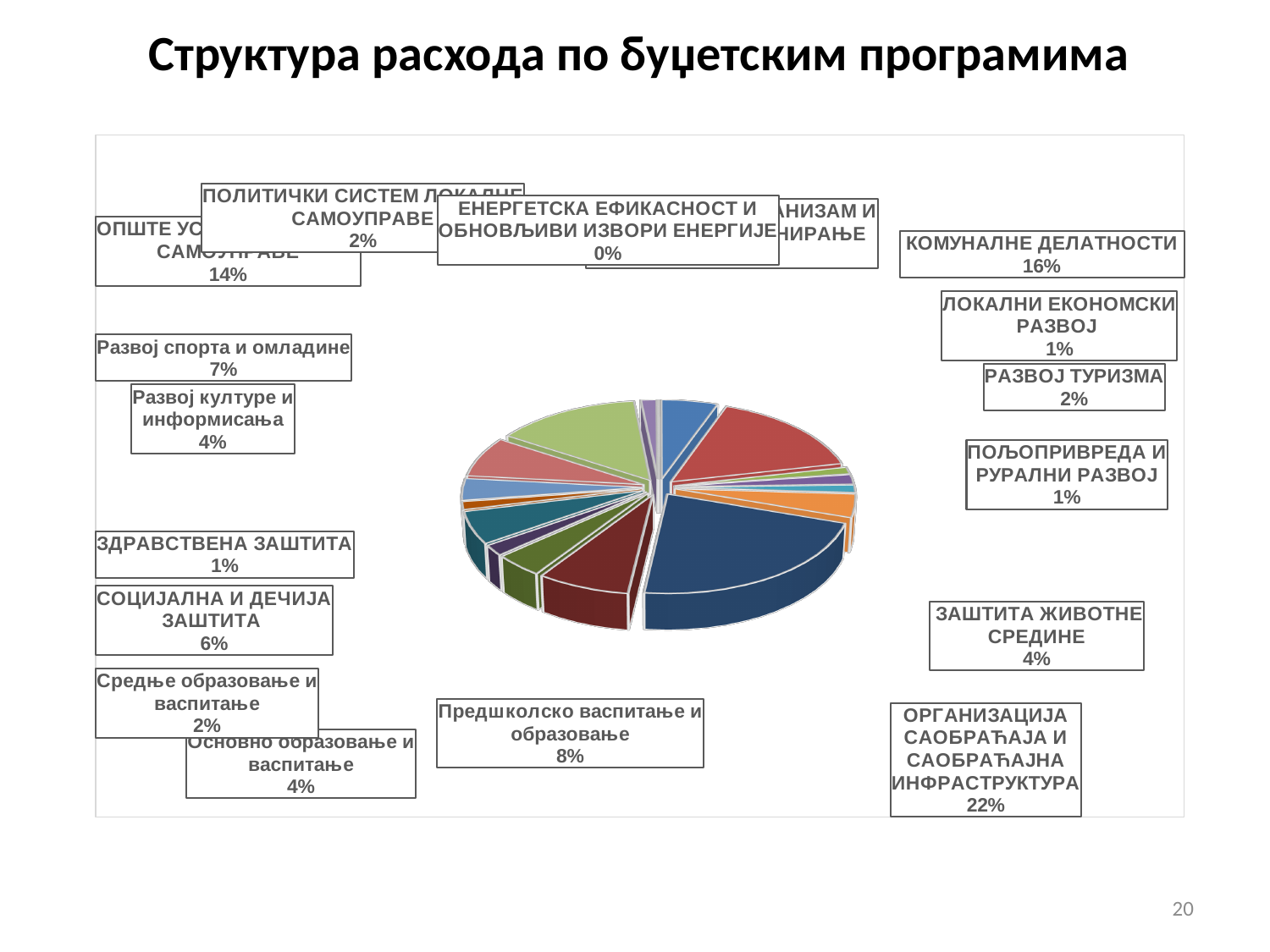
What percentage is shown for Развој спорта и омладине? 7% What is the title of the chart on the slide? Структура расхода по буџетским програмима By how many percentage points does the share for ОРГАНИЗАЦИЈА САОБРАЋАЈА И САОБРАЋАЈНА ИНФРАСТРУКТУРА exceed the share for КОМУНАЛНЕ ДЕЛАТНОСТИ? 6 percentage points What kind of chart is shown on the slide? pie chart Which budget programme has the smallest share of expenditure? ЕНЕРГЕТСКА ЕФИКАСНОСТ И ОБНОВЉИВИ ИЗВОРИ ЕНЕРГИЈЕ What share of expenditure goes to КОМУНАЛНЕ ДЕЛАТНОСТИ? 16% What percentage is shown for СОЦИЈАЛНА И ДЕЧИЈА ЗАШТИТА? 6% What percentage is shown for Предшколско васпитање и образовање? 8% What share of expenditure goes to ОРГАНИЗАЦИЈА САОБРАЋАЈА И САОБРАЋАЈНА ИНФРАСТРУКТУРА? 22% Which has a larger share: КОМУНАЛНЕ ДЕЛАТНОСТИ or Предшколско васпитање и образовање? КОМУНАЛНЕ ДЕЛАТНОСТИ Which budget programme has the largest share of expenditure? ОРГАНИЗАЦИЈА САОБРАЋАЈА И САОБРАЋАЈНА ИНФРАСТРУКТУРА What percentage is shown for ЕНЕРГЕТСКА ЕФИКАСНОСТ И ОБНОВЉИВИ ИЗВОРИ ЕНЕРГИЈЕ? 0%